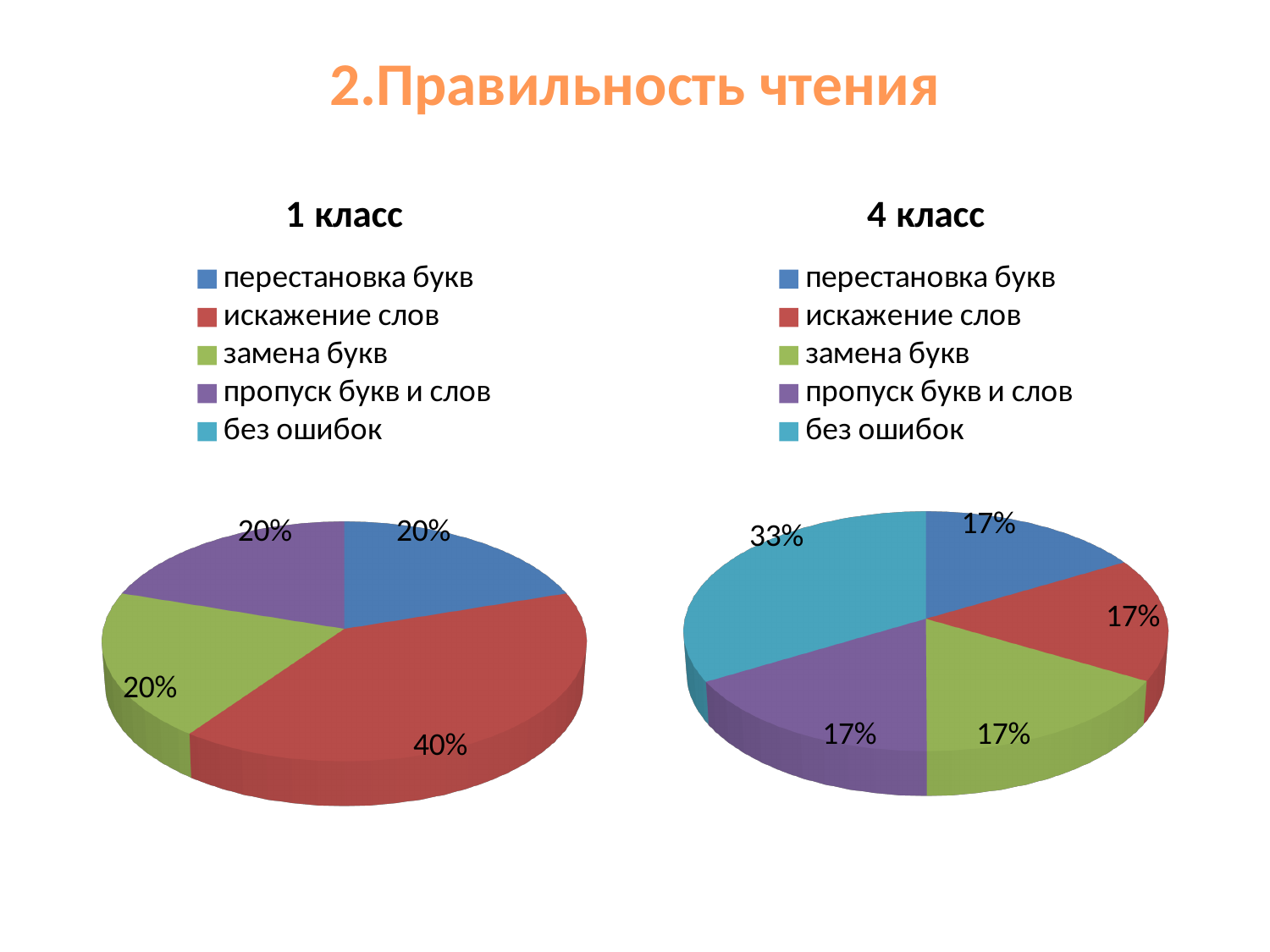
Which is larger: the share for искажение слов in the "1 класс" chart or in the "4 класс" chart? 1 класс What type of chart is used for "1 класс" and "4 класс"? pie chart In the "1 класс" chart, what share is labelled for перестановка букв? 20% How many slices are shown in the "4 класс" pie chart? 5 In the "4 класс" chart, what is the difference between the shares for без ошибок and пропуск букв и слов? 16% In the "1 класс" chart, what is the difference between the shares for искажение слов and замена букв? 20% In the "1 класс" chart, what share is labelled for искажение слов? 40% In the "4 класс" chart, what share is labelled for без ошибок? 33% In the "4 класс" chart, which category has the largest slice? без ошибок In the "1 класс" chart, which category has the largest slice? искажение слов In the "4 класс" chart, what share is labelled for замена букв? 17% How many entries does the legend of the "1 класс" chart list? 5